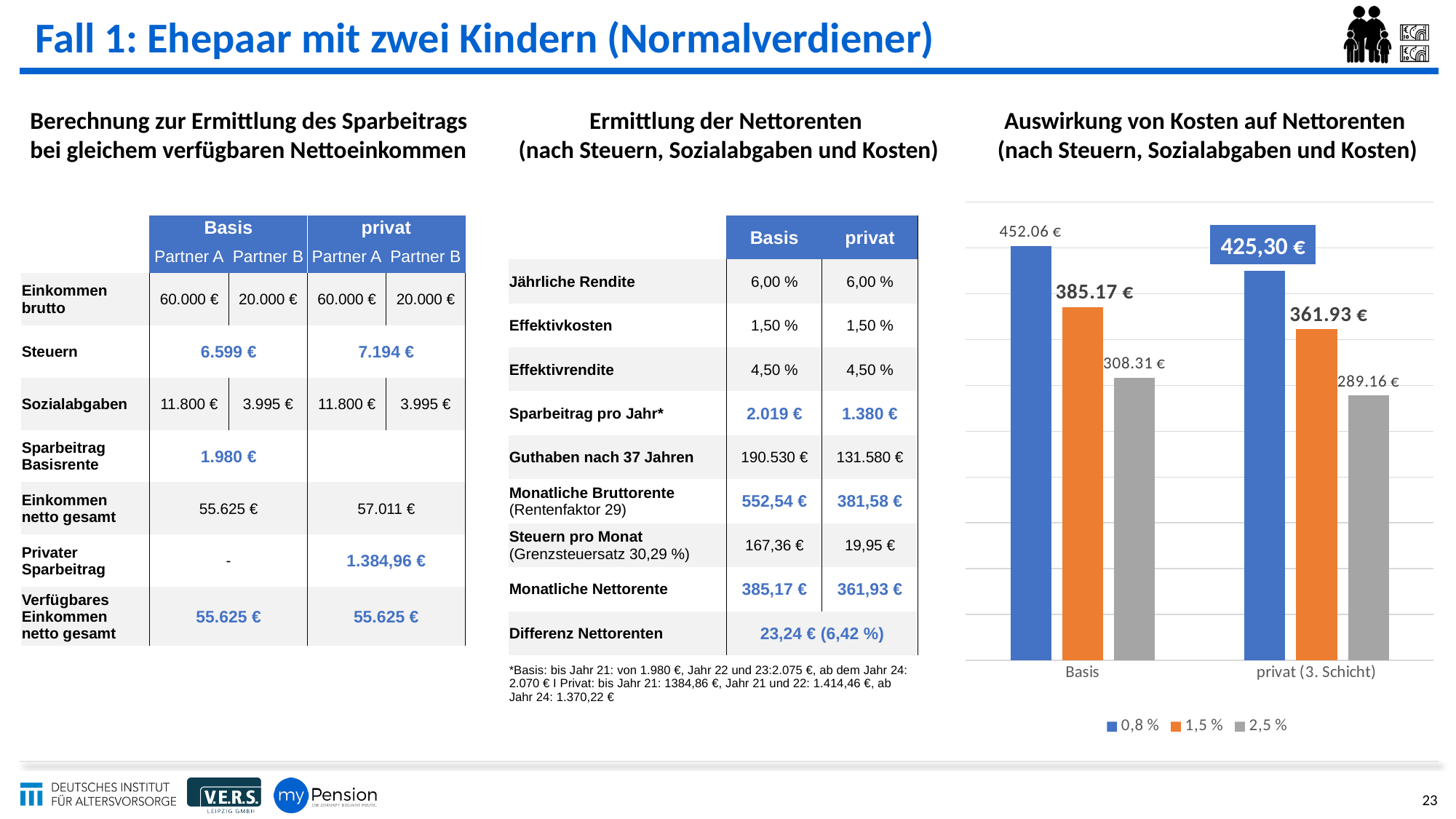
In the chart 'Auswirkung von Kosten auf Nettorenten', is the 1,5 % value for Basis larger or smaller than the 1,5 % value for privat (3. Schicht)? larger In the chart 'Auswirkung von Kosten auf Nettorenten', which series has the highest value for Basis? 0,8 % In the chart 'Auswirkung von Kosten auf Nettorenten', what is the difference between the 0,8 % and 2,5 % values for Basis? 143.75 € What kind of chart is shown on the right side of the slide? bar chart In the chart 'Auswirkung von Kosten auf Nettorenten', what is the value of the 0,8 % bar for Basis? 452.06 € In the chart 'Auswirkung von Kosten auf Nettorenten', what is the value of the 0,8 % bar for privat (3. Schicht)? 425,30 € In the chart 'Auswirkung von Kosten auf Nettorenten', what is the difference between the 1,5 % values for Basis and privat (3. Schicht)? 23.24 € How many categories are shown on the x axis of the chart 'Auswirkung von Kosten auf Nettorenten'? 2 In the chart 'Auswirkung von Kosten auf Nettorenten', what is the value of the 2,5 % bar for Basis? 308.31 € In the chart 'Auswirkung von Kosten auf Nettorenten', which bar has the lowest value overall? 2,5 % for privat (3. Schicht) In the chart 'Auswirkung von Kosten auf Nettorenten', what is the value of the 1,5 % bar for privat (3. Schicht)? 361.93 € How many series does the legend of the chart 'Auswirkung von Kosten auf Nettorenten' list? 3